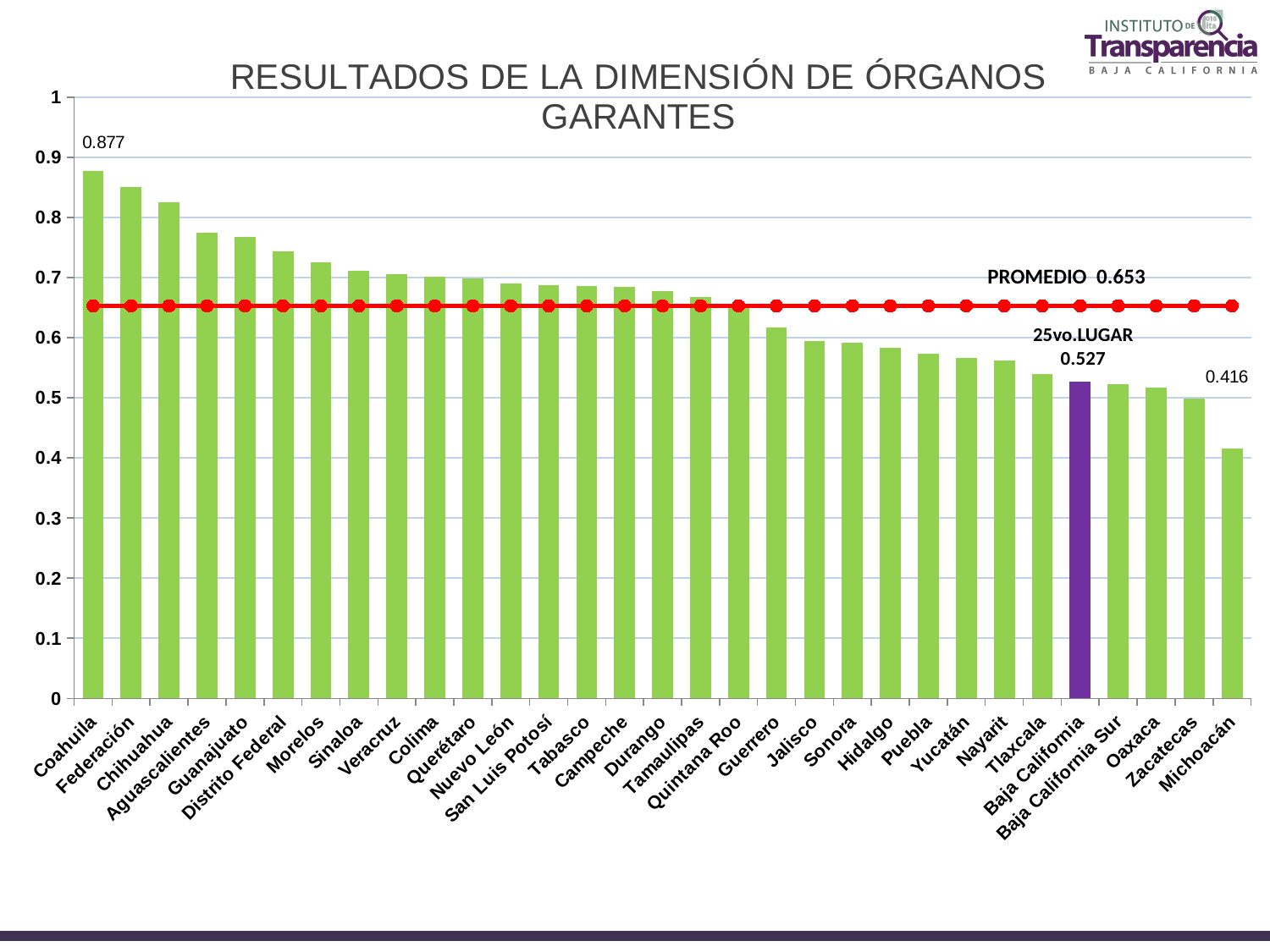
What is the difference between the values for Coahuila and Baja California? 0.350 Which is larger, the value for Baja California or the value for Michoacán? Baja California How many categories are shown on the x axis? 31 Is the value for Chihuahua greater or less than 0.8? greater Is the value for Hidalgo greater or less than 0.6? less What is the value for Coahuila? 0.877 What is the value of the PROMEDIO line shown on the chart? 0.653 What is the value for Michoacán? 0.416 Which category has the highest value? Coahuila What is the value for Baja California? 0.527 Which category has the lowest value? Michoacán What is the difference between the values for Coahuila and Michoacán? 0.461